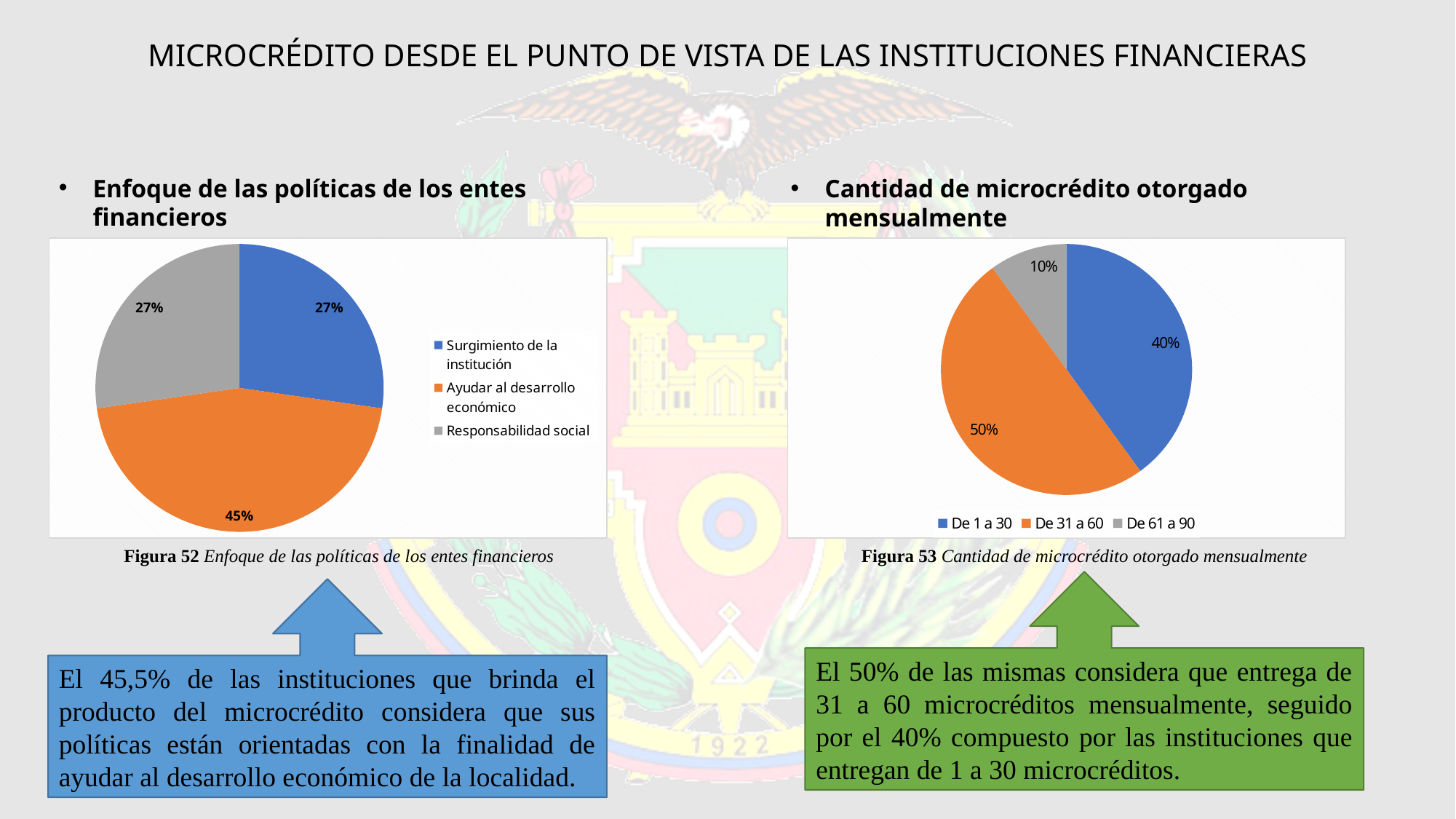
What kind of chart is 'Enfoque de las políticas de los entes financieros'? Pie chart In the chart 'Cantidad de microcrédito otorgado mensualmente', what share is labelled for 'De 31 a 60'? 50% In the chart 'Enfoque de las políticas de los entes financieros', what share is labelled for 'Responsabilidad social'? 27% In the chart 'Enfoque de las políticas de los entes financieros', what share is labelled for 'Ayudar al desarrollo económico'? 45% In the chart 'Cantidad de microcrédito otorgado mensualmente', which category has the smallest slice? De 61 a 90 In the chart 'Cantidad de microcrédito otorgado mensualmente', what share is labelled for 'De 61 a 90'? 10% In the chart 'Cantidad de microcrédito otorgado mensualmente', how many categories does the legend list? 3 In the chart 'Cantidad de microcrédito otorgado mensualmente', what colour is the slice for 'De 31 a 60'? Orange In the chart 'Cantidad de microcrédito otorgado mensualmente', what is the difference between the shares for 'De 1 a 30' and 'De 61 a 90'? 30% In the chart 'Enfoque de las políticas de los entes financieros', which category has the largest slice? Ayudar al desarrollo económico In the chart 'Cantidad de microcrédito otorgado mensualmente', which is larger: 'De 1 a 30' or 'De 31 a 60'? De 31 a 60 In the chart 'Enfoque de las políticas de los entes financieros', how many categories does the legend list? 3